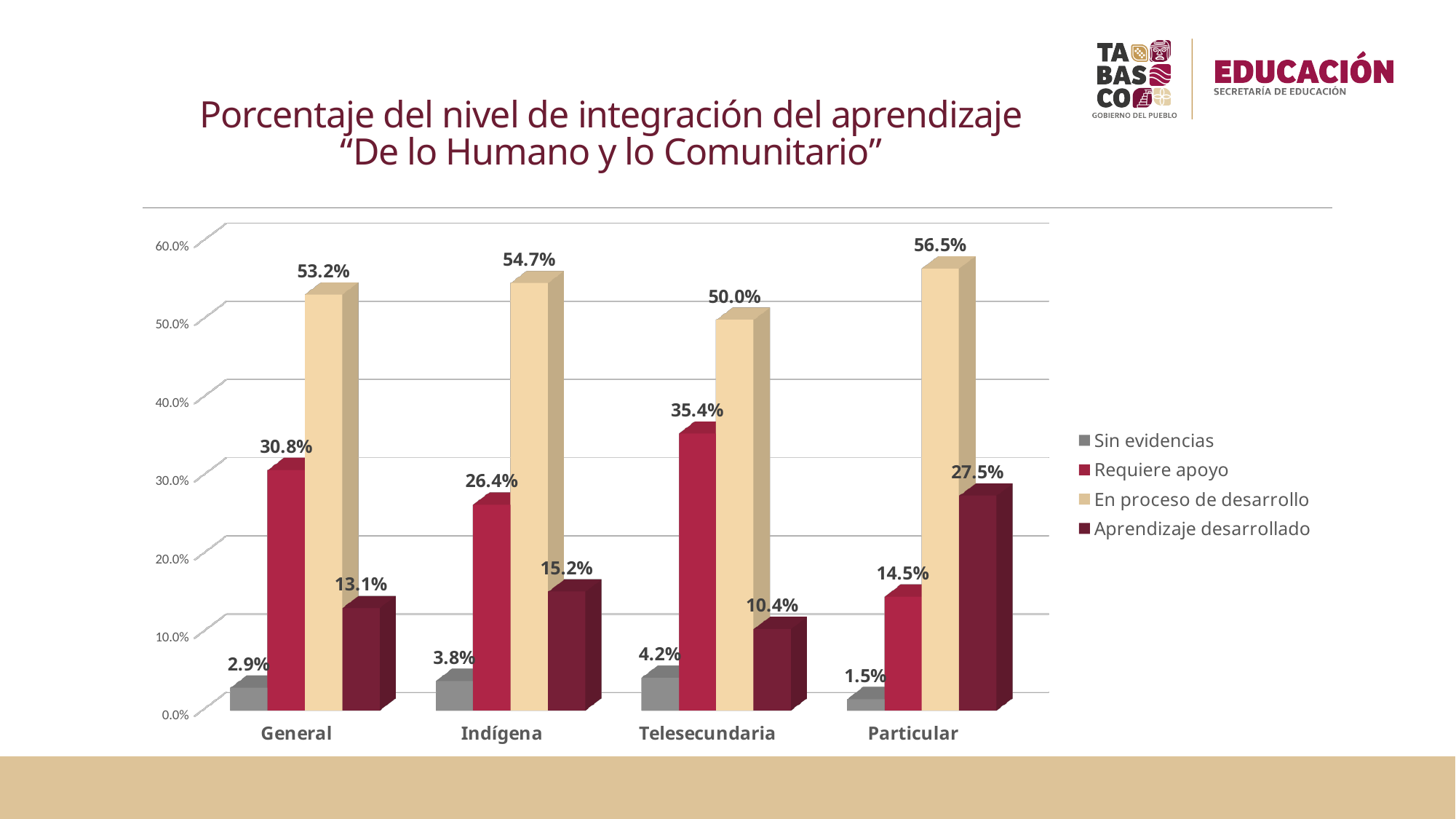
What is the value for "Aprendizaje desarrollado" in the Particular category? 27.5% Which is larger: "Aprendizaje desarrollado" for Indígena or for Telesecundaria? Indígena How many categories are shown on the x axis? 4 How many series does the legend list? 4 What is the value for "Requiere apoyo" in the Telesecundaria category? 35.4% Which category has the highest value for "En proceso de desarrollo"? Particular What is the value for "Sin evidencias" in the Indígena category? 3.8% What kind of chart is shown on the slide? Bar chart What is the value for "En proceso de desarrollo" in the General category? 53.2% What is the difference between the "Requiere apoyo" values for General and Particular? 16.3% Which legend entry is shown in the light beige colour? En proceso de desarrollo Which category has the lowest value for "Sin evidencias"? Particular